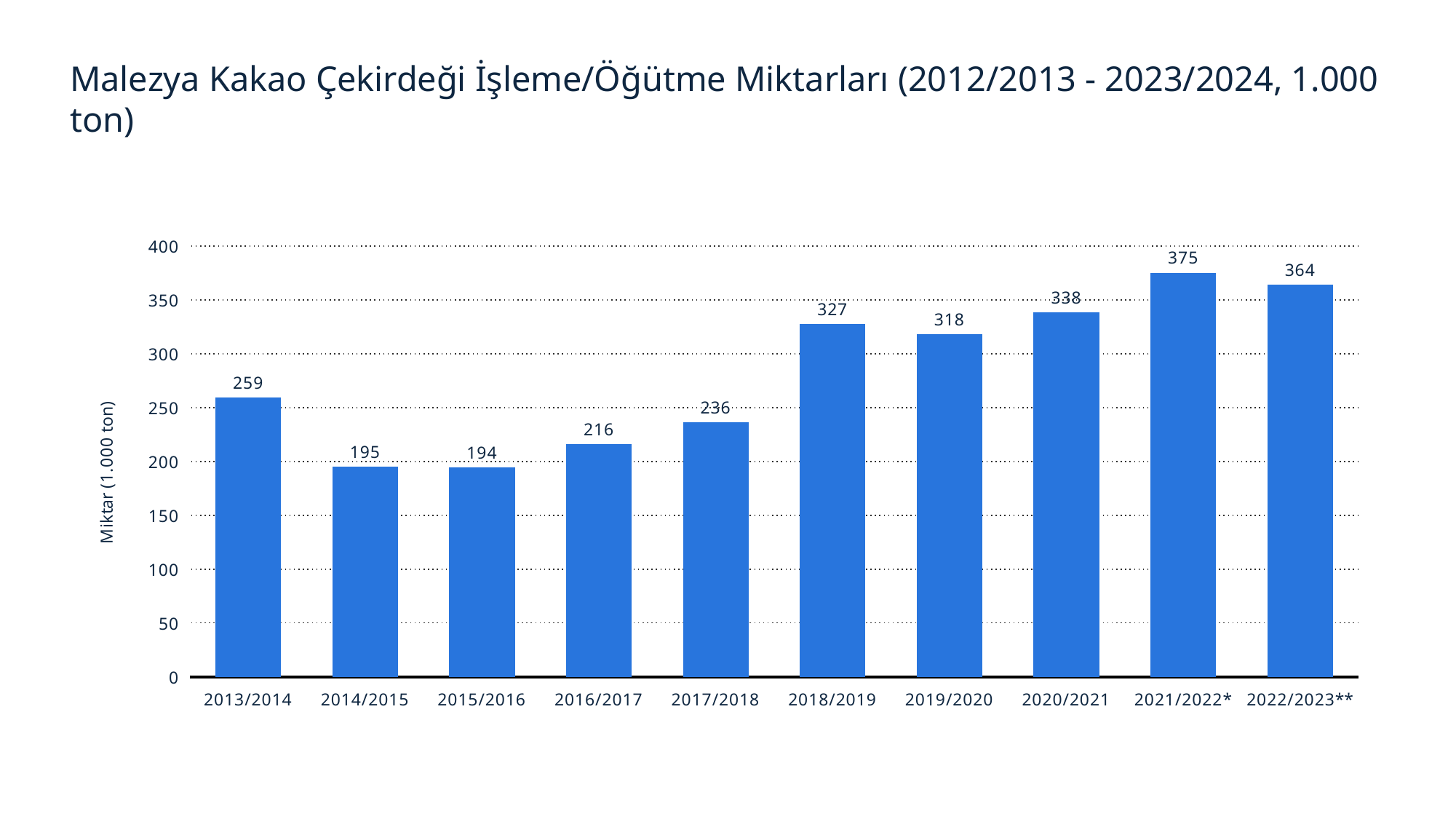
What is the value for 2022/2023**? 364 What is the difference between the values for 2018/2019 and 2017/2018? 91 Which year has the lowest value? 2015/2016 What is the label of the y axis? Miktar (1.000 ton) What is the value for 2018/2019? 327 What is the value for 2013/2014? 259 What is the difference between the values for 2021/2022* and 2022/2023**? 11 Which is larger, the value for 2019/2020 or the value for 2020/2021? 2020/2021 Which year has the highest value? 2021/2022* Is the value for 2016/2017 greater or less than 200? greater What kind of chart is shown on the slide? bar chart How many years are shown on the x axis? 10